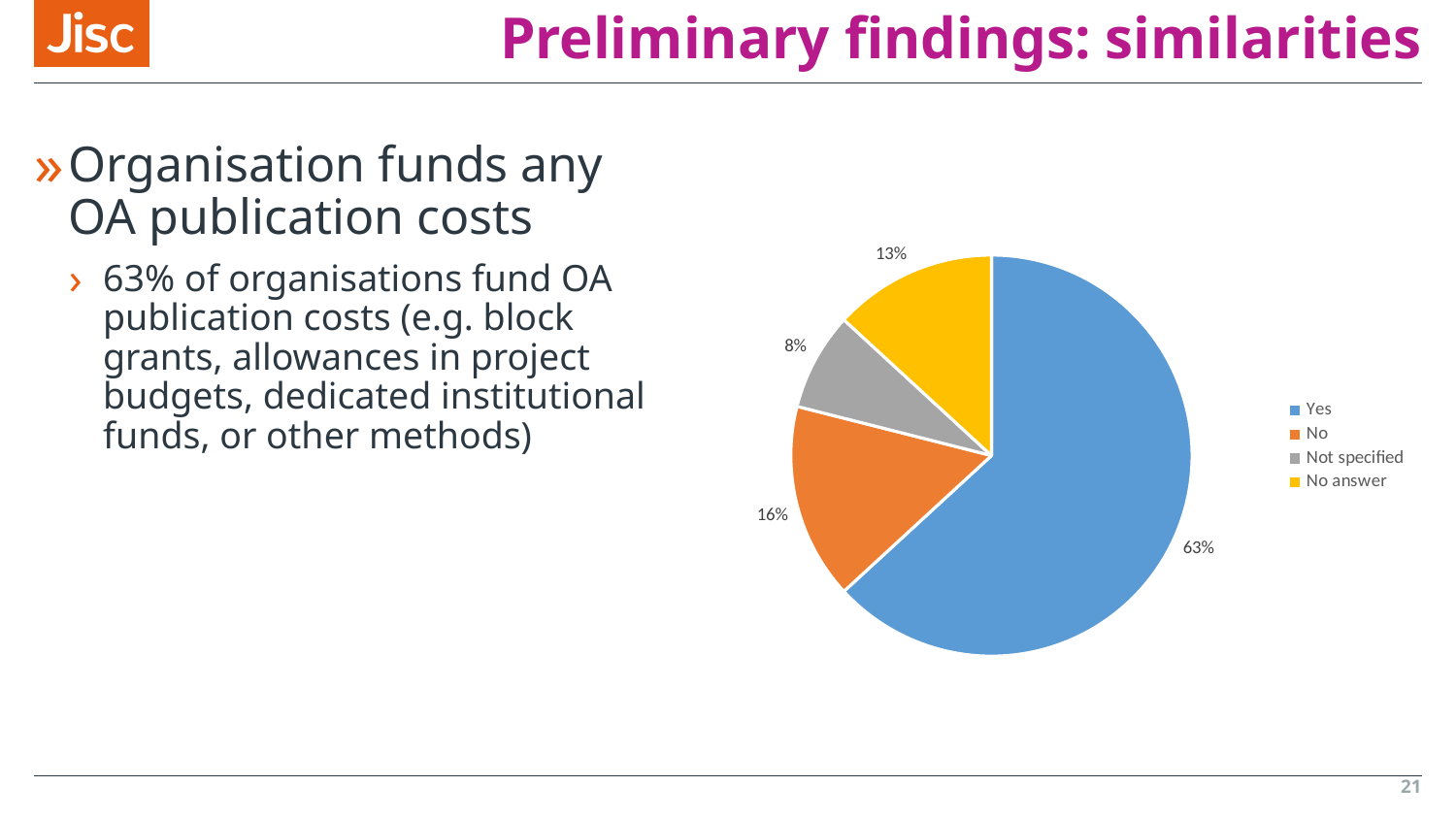
Which slice is larger, 'No' or 'No answer'? No Which category has the largest slice in the pie chart? Yes What colour is the 'No answer' slice in the pie chart? yellow What colour is the 'Yes' slice in the pie chart? blue What percentage of the pie chart is the 'Yes' slice? 63% What percentage of the pie chart is the 'No' slice? 16% How many categories does the pie chart's legend list? 4 Which category has the smallest slice in the pie chart? Not specified What kind of chart is shown on the slide? pie chart What is the difference in percentage points between the 'Yes' slice and the 'No' slice? 47 What percentage of the pie chart is the 'No answer' slice? 13% What percentage of the pie chart is the 'Not specified' slice? 8%